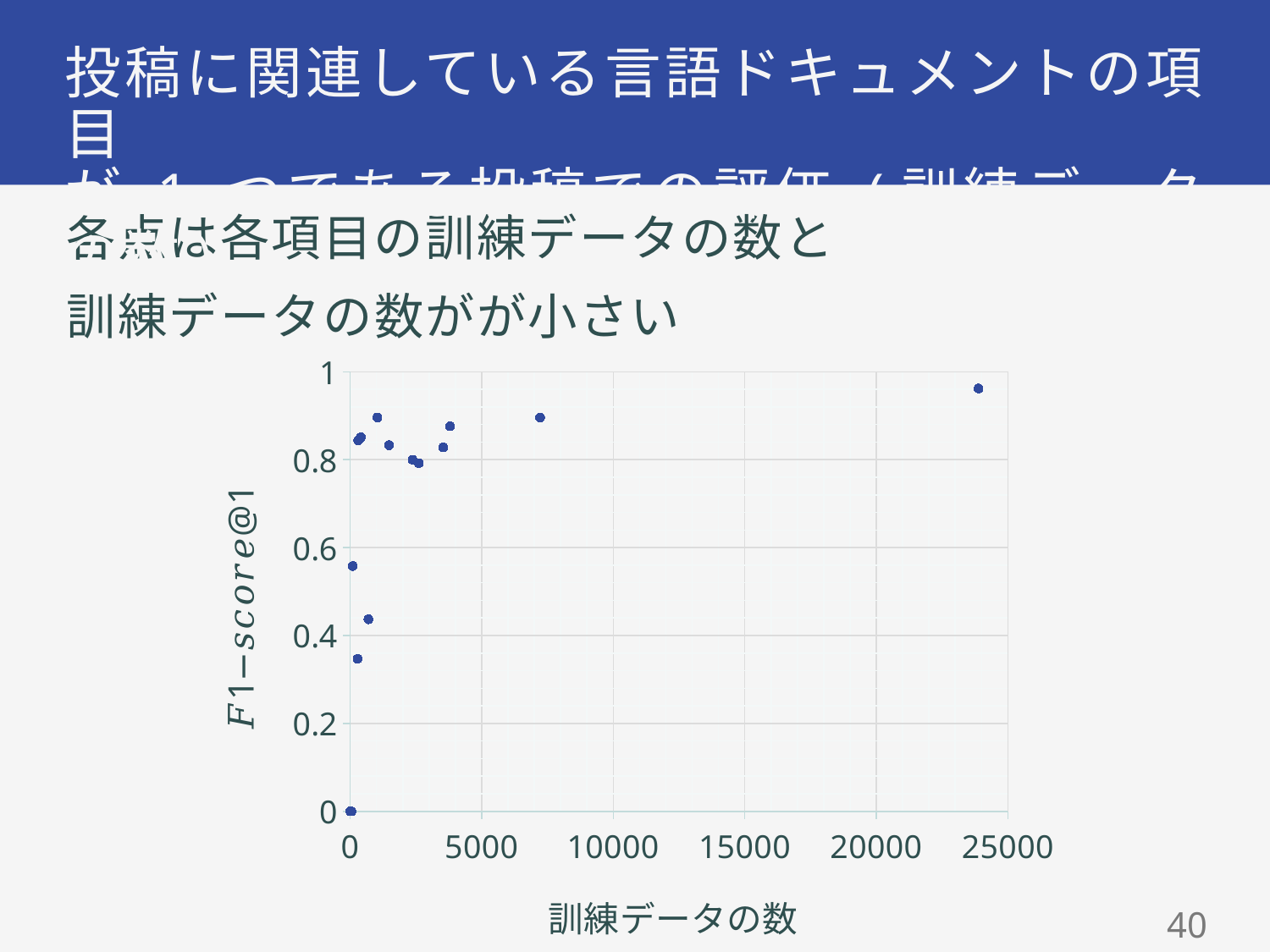
Is the F1-score@1 of the point plotted near 7000 training data greater or less than 0.8? greater What is the largest tick value shown on the x axis? 25000 What kind of chart is shown on the slide? scatter chart How many points are plotted with more than 10000 training data? 1 What is the highest tick value shown on the y axis? 1 What is the F1-score@1 of the point plotted at 0 training data? 0 What is the label of the x axis of the chart? 訓練データの数 Overall, does F1-score@1 rise or fall as the number of training data increases? rise Does the point with the highest F1-score@1 have the largest or the smallest number of training data? largest What is the label of the y axis of the chart? F1-score@1 Is the F1-score@1 of the point with the largest number of training data greater or less than 0.8? greater